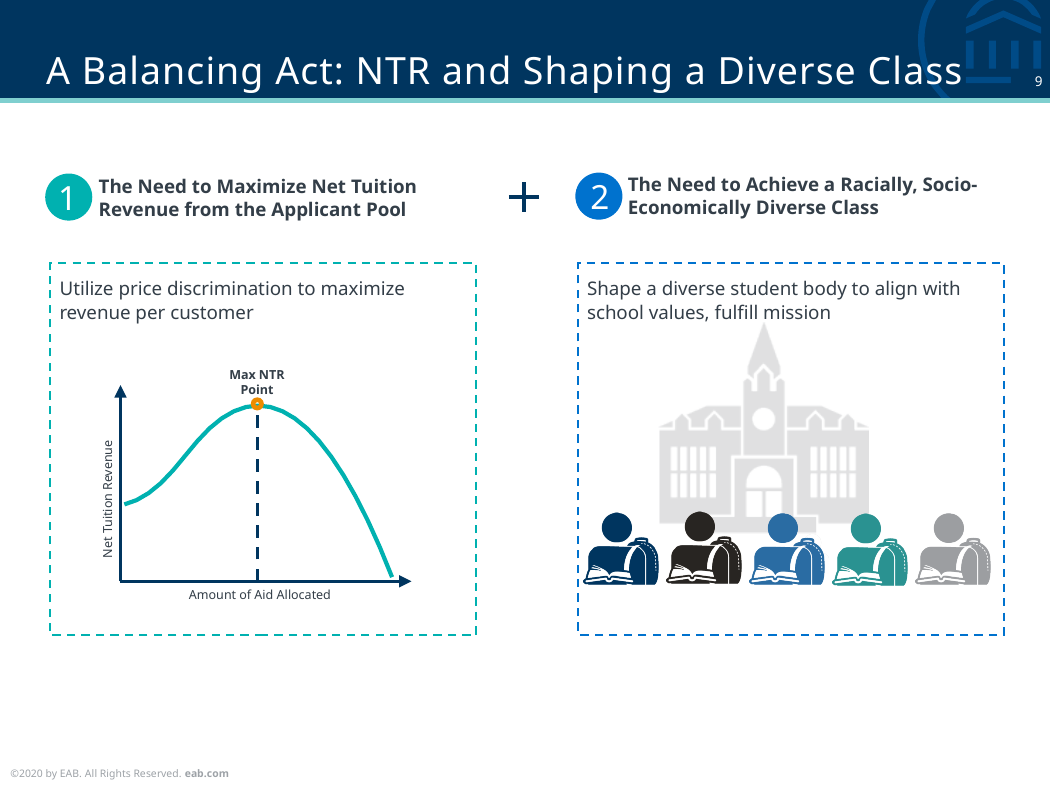
What kind of chart is shown in the left panel under 'Utilize price discrimination to maximize revenue per customer'? Line chart In the left chart, what is the label on the y axis? Net Tuition Revenue In the left chart, what is the label on the x axis? Amount of Aid Allocated How many lines are plotted in the left chart? 1 In the left chart, how does Net Tuition Revenue change as Amount of Aid Allocated increases along the x axis? It rises, then falls